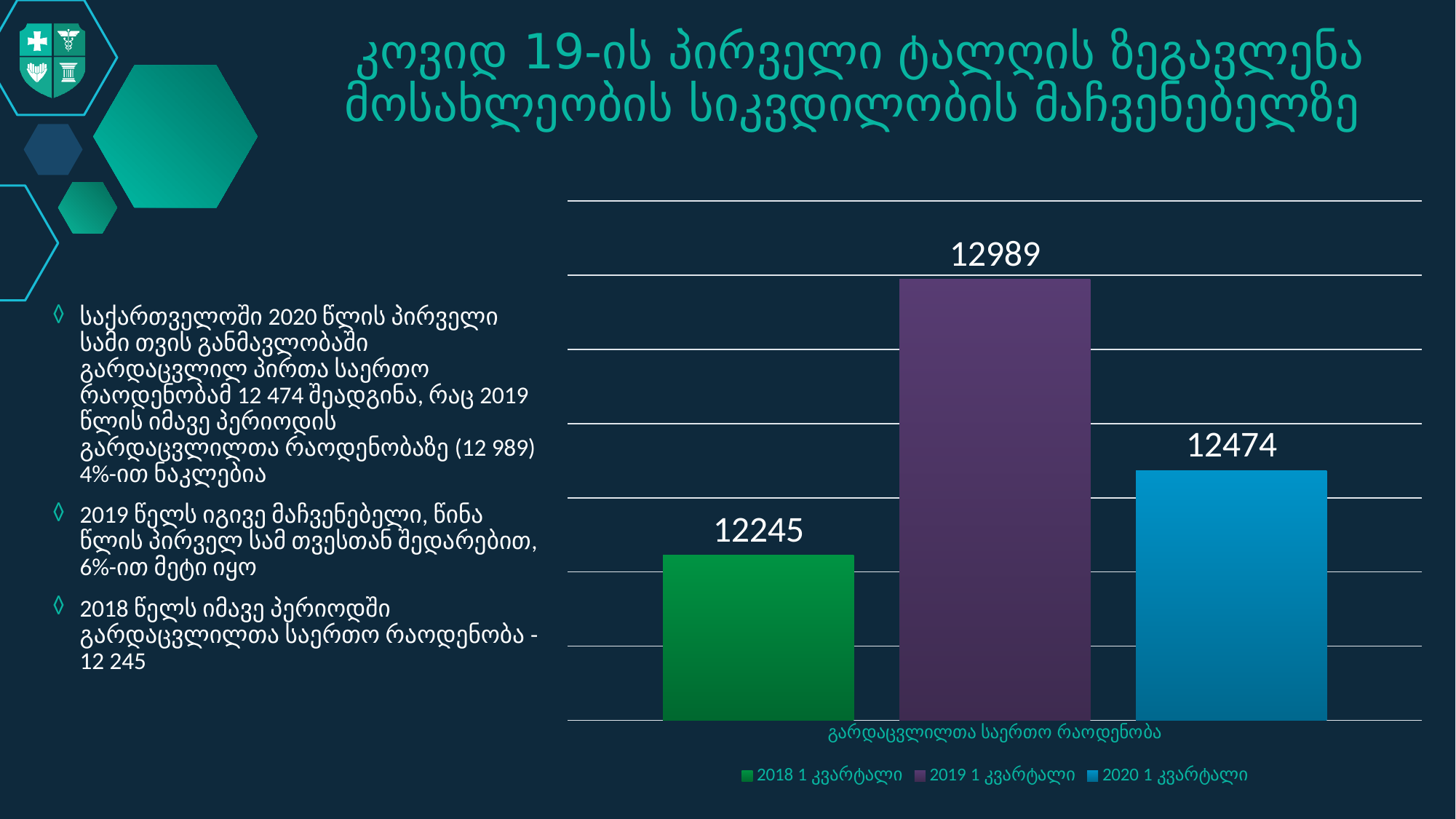
What is the value for the series "2019 1 კვარტალი"? 12989 What is the value for the series "2020 1 კვარტალი"? 12474 What is the value for the series "2018 1 კვარტალი"? 12245 What kind of chart is shown on the slide? Bar chart Which is larger, the value for "2019 1 კვარტალი" or the value for "2018 1 კვარტალი"? 2019 1 კვარტალი What colour is the bar for "2020 1 კვარტალი"? Blue Which series has the lowest value? 2018 1 კვარტალი What is the difference between the values for "2020 1 კვარტალი" and "2018 1 კვარტალი"? 229 What is the difference between the values for "2019 1 კვარტალი" and "2020 1 კვარტალი"? 515 What is the category label shown on the x axis of the chart? გარდაცვლილთა საერთო რაოდენობა How many series does the legend list? 3 Which series has the highest value? 2019 1 კვარტალი